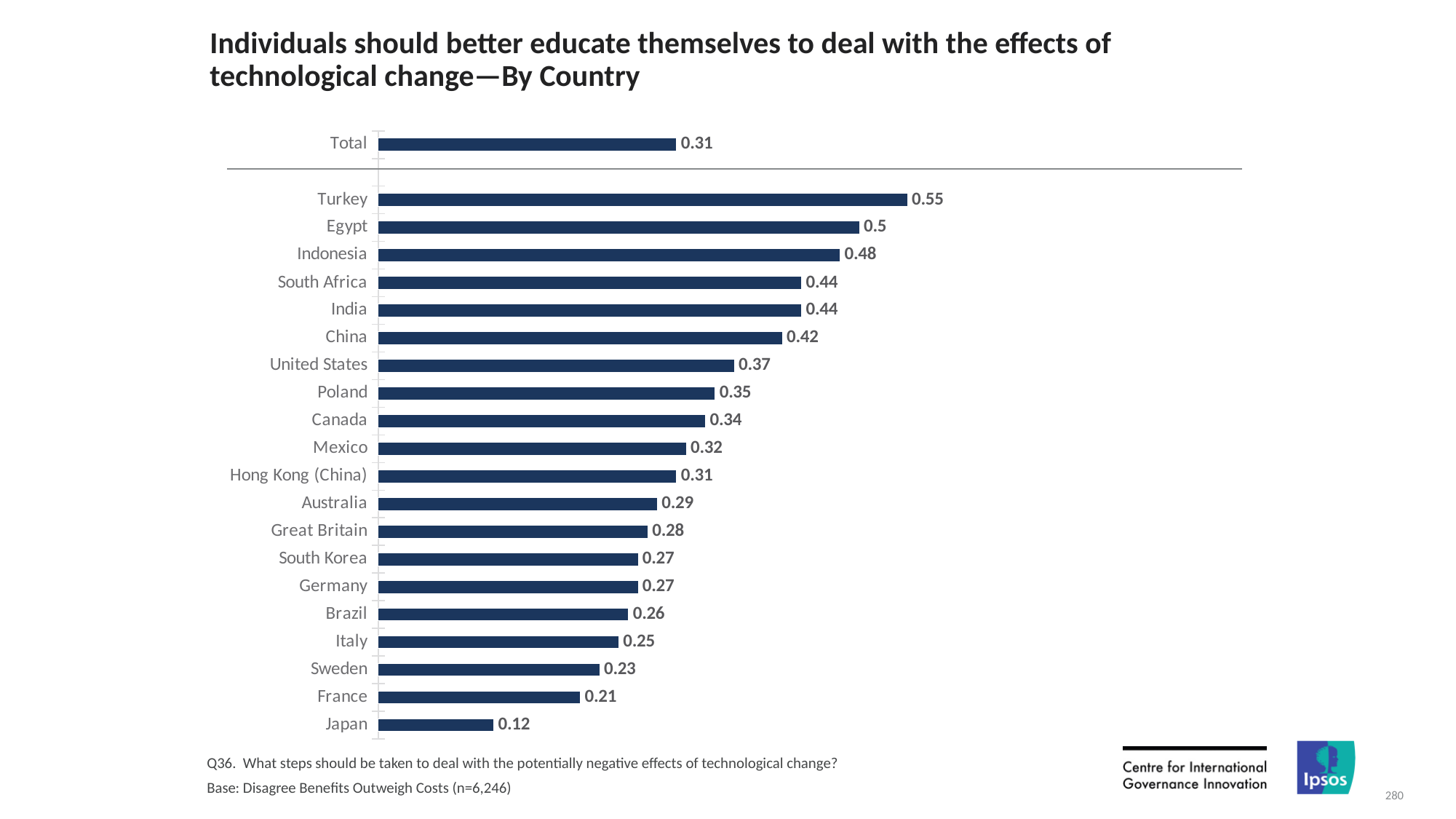
What is the value for Japan? 0.12 What is the difference between the values for Egypt and France? 0.29 What is the value for Canada? 0.34 Which country has the highest value? Turkey Which country has the lowest value? Japan What kind of chart is shown on the slide? Bar chart What is the value for Turkey? 0.55 What is the value for the Total bar? 0.31 How many countries are listed below the Total bar? 20 Do the country values rise or fall going down the chart from Turkey to Japan? Fall What is the title of the chart? Individuals should better educate themselves to deal with the effects of technological change—By Country Which has a larger value, China or Poland? China